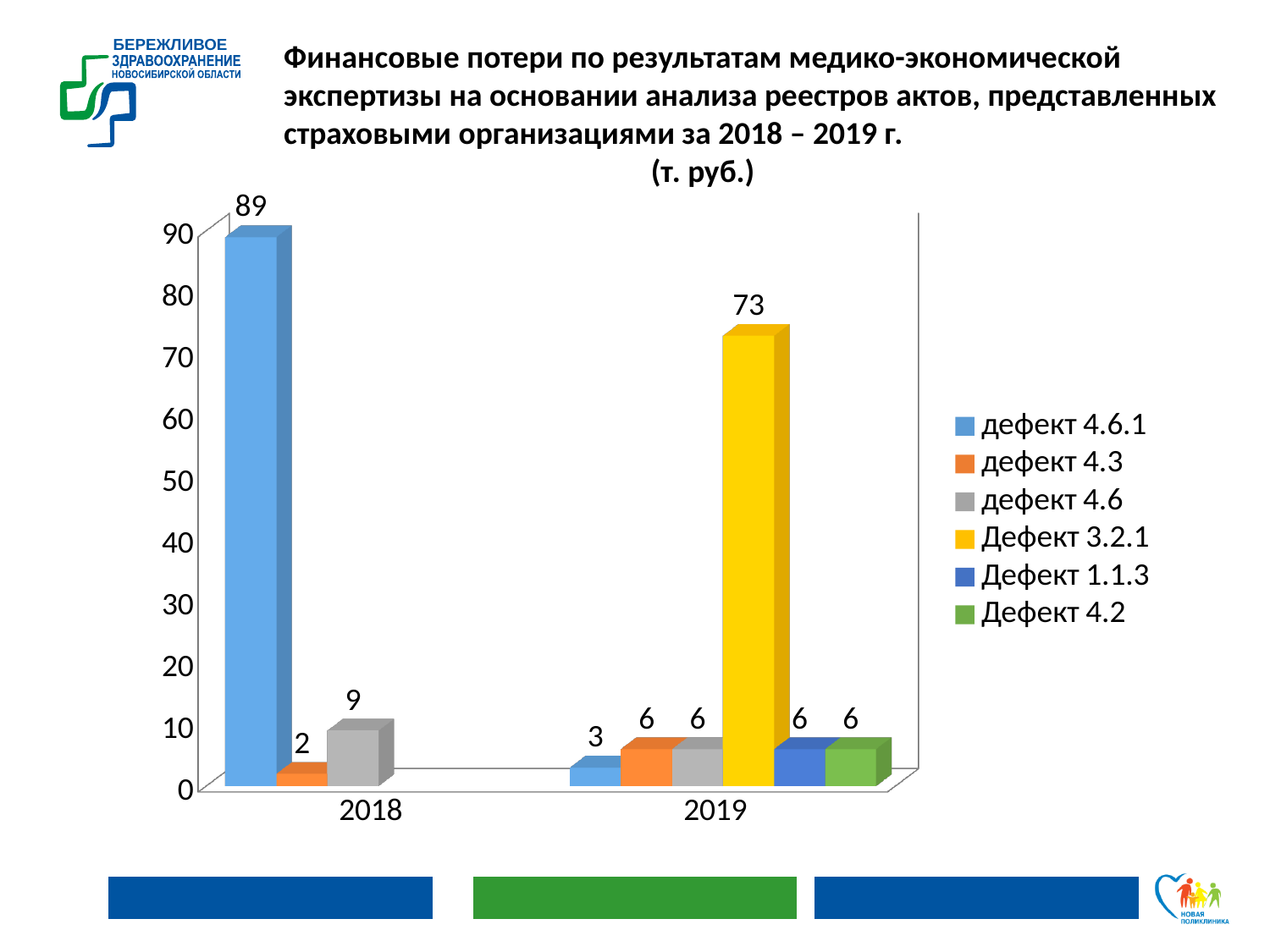
What colour represents Дефект 3.2.1 in the chart? Yellow Which series has the highest value in 2019? Дефект 3.2.1 What is the value for дефект 4.3 in 2018? 2 What kind of chart is shown on the slide? Bar chart What is the value for Дефект 3.2.1 in 2019? 73 What is the value for дефект 4.6 in 2018? 9 What is the value for дефект 4.6.1 in 2018? 89 Which series has the lowest value in 2018? дефект 4.3 Which is larger: the value for дефект 4.6 in 2018 or the value for дефект 4.6 in 2019? дефект 4.6 in 2018 How many series does the legend list? 6 What is the value for дефект 4.6.1 in 2019? 3 What is the difference between the value for дефект 4.6.1 in 2018 and the value for Дефект 3.2.1 in 2019? 16